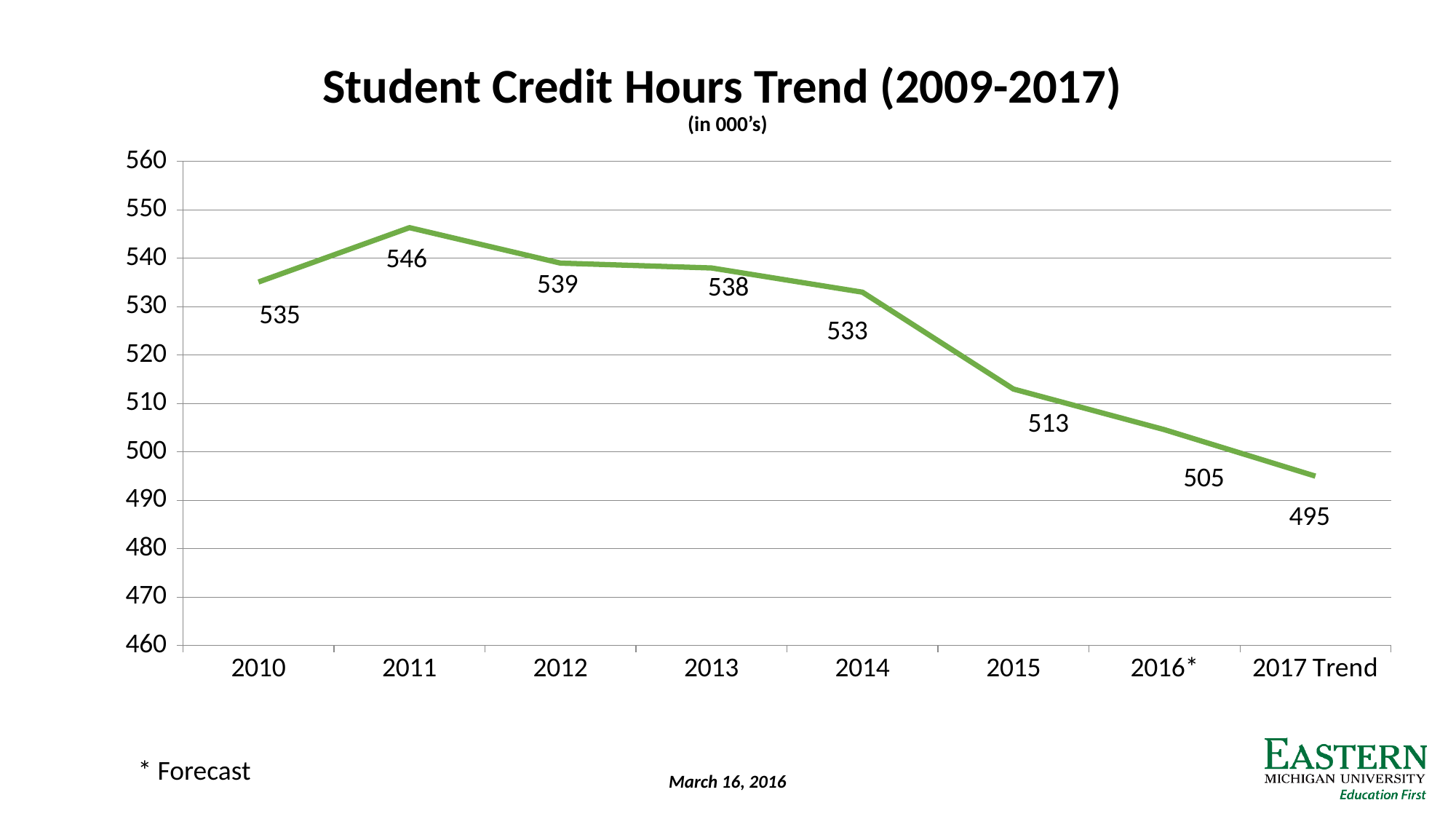
Do the values rise or fall from 2011 to 2017 Trend? fall What is the value for 2011? 546 What is the value for 2015? 513 What is the difference between the values for 2011 and 2017 Trend? 51 What is the value for 2017 Trend? 495 What kind of chart is shown? line chart Is the value for 2016* greater or less than 500? greater Which category has the lowest value? 2017 Trend Which year has the highest value? 2011 How many data points are plotted on the chart? 8 What is the difference between the values for 2014 and 2015? 20 Which is larger, the value for 2010 or the value for 2016*? 2010